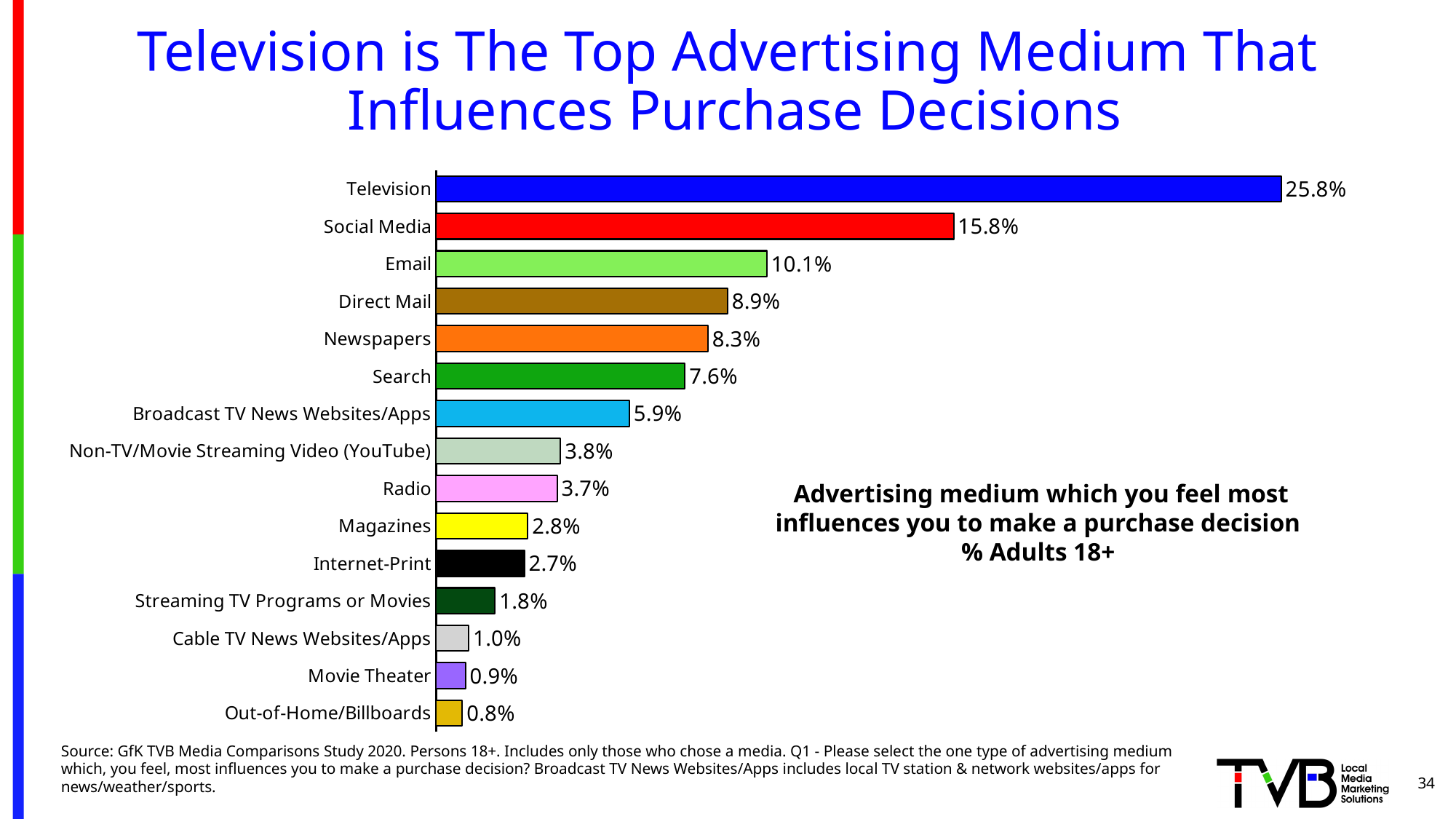
Which advertising medium has the lowest value in the chart? Out-of-Home/Billboards What is the difference between the values for Email and Direct Mail? 1.2% What is the value shown for Radio? 3.7% Which advertising medium has the highest value in the chart? Television What is the value shown for Social Media? 15.8% What percentage of adults 18+ chose Television as the advertising medium that most influences their purchase decisions? 25.8% Which has a larger value, Newspapers or Search? Newspapers What colour is the bar for Magazines? Yellow What is the difference between the values for Television and Social Media? 10.0% What kind of chart is shown on the slide? Bar chart How many advertising media are listed in the chart? 15 What is the value shown for Broadcast TV News Websites/Apps? 5.9%